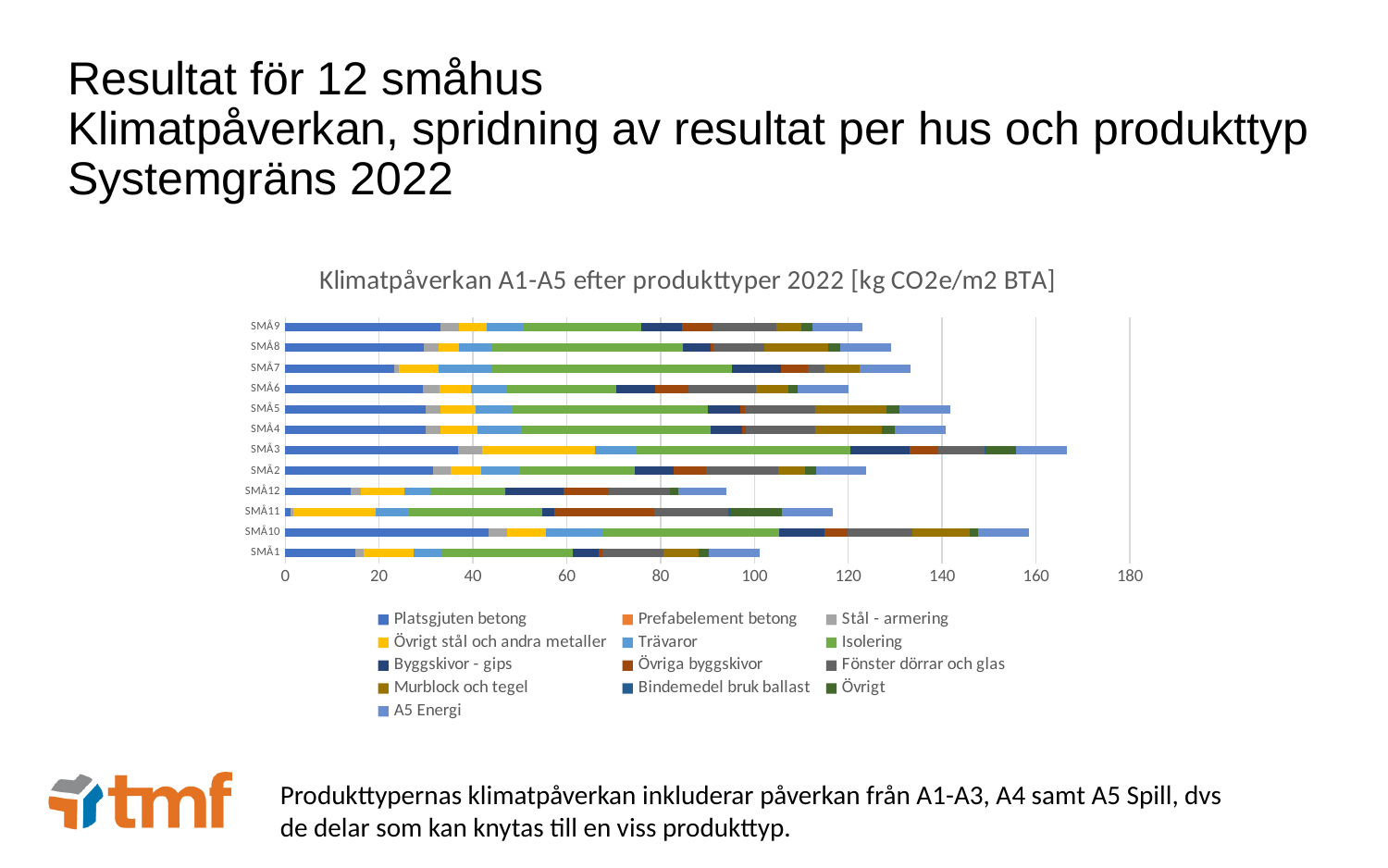
What is the highest tick value shown on the x axis of the chart? 180 Is the total value for SMÅ3 greater or less than 160? greater Is the total value for SMÅ6 greater or less than 140? less Which house has the highest total climate impact in the chart? SMÅ3 Is the total value for SMÅ10 greater or less than 140? greater Which has a larger total climate impact, SMÅ10 or SMÅ6? SMÅ10 How many houses (categories) are plotted on the y axis of the chart? 12 Which house has the lowest total climate impact in the chart? SMÅ12 What kind of chart is shown on the slide? Stacked bar chart What is the title of the chart? Klimatpåverkan A1-A5 efter produkttyper 2022 [kg CO2e/m2 BTA] How many series does the chart legend list? 13